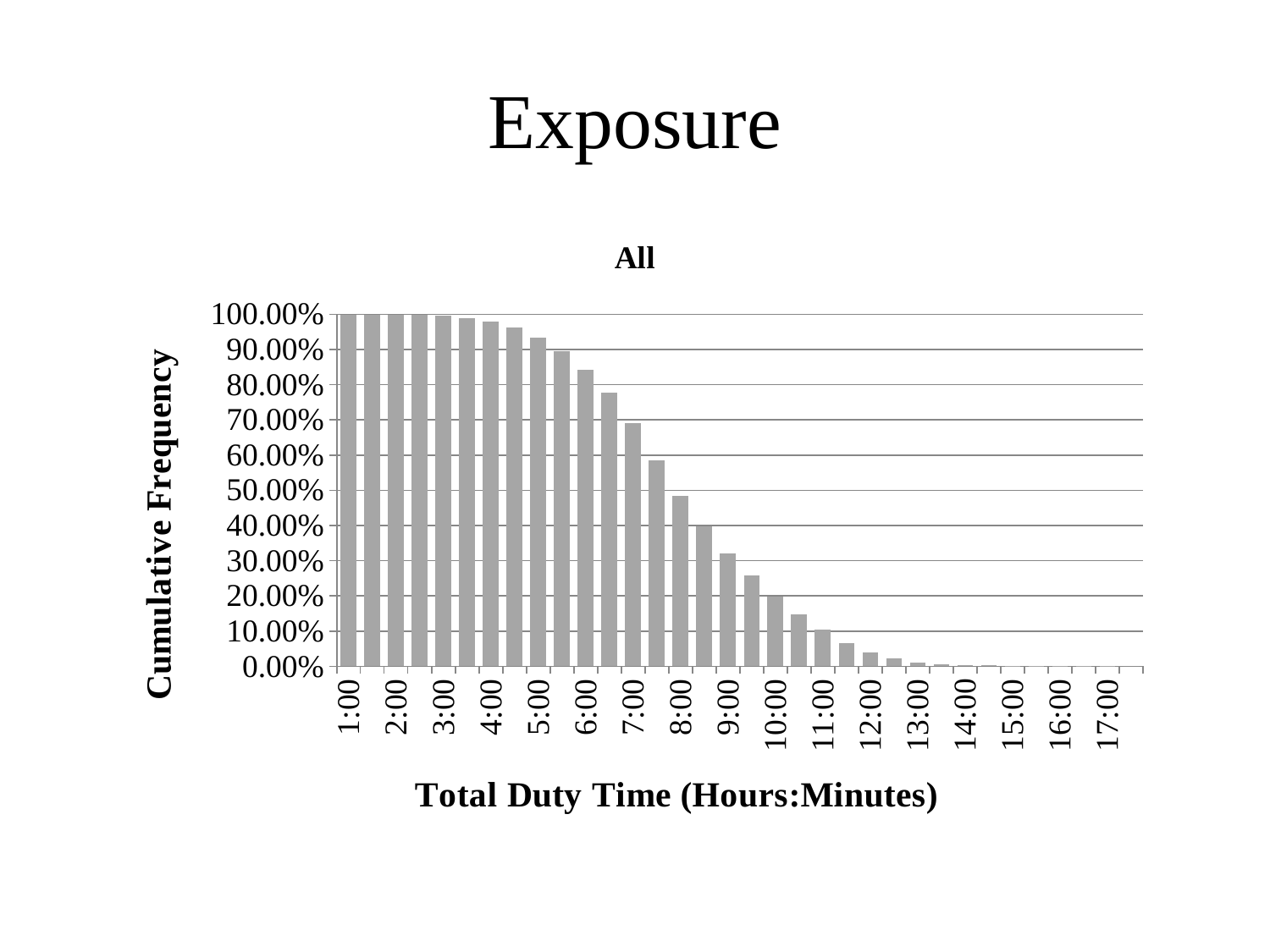
Is the cumulative frequency at 7:00 greater or less than 60.00%? greater What type of chart is shown on the slide? bar chart Is the cumulative frequency at 12:00 greater or less than 10.00%? less Is the cumulative frequency at 11:00 greater or less than 20.00%? less What is the label of the vertical axis? Cumulative Frequency How many hour labels are shown on the x axis? 17 What is the title of the chart? All Do the cumulative frequency values rise or fall as total duty time increases along the x axis? fall Which has a higher cumulative frequency, 7:00 or 9:00? 7:00